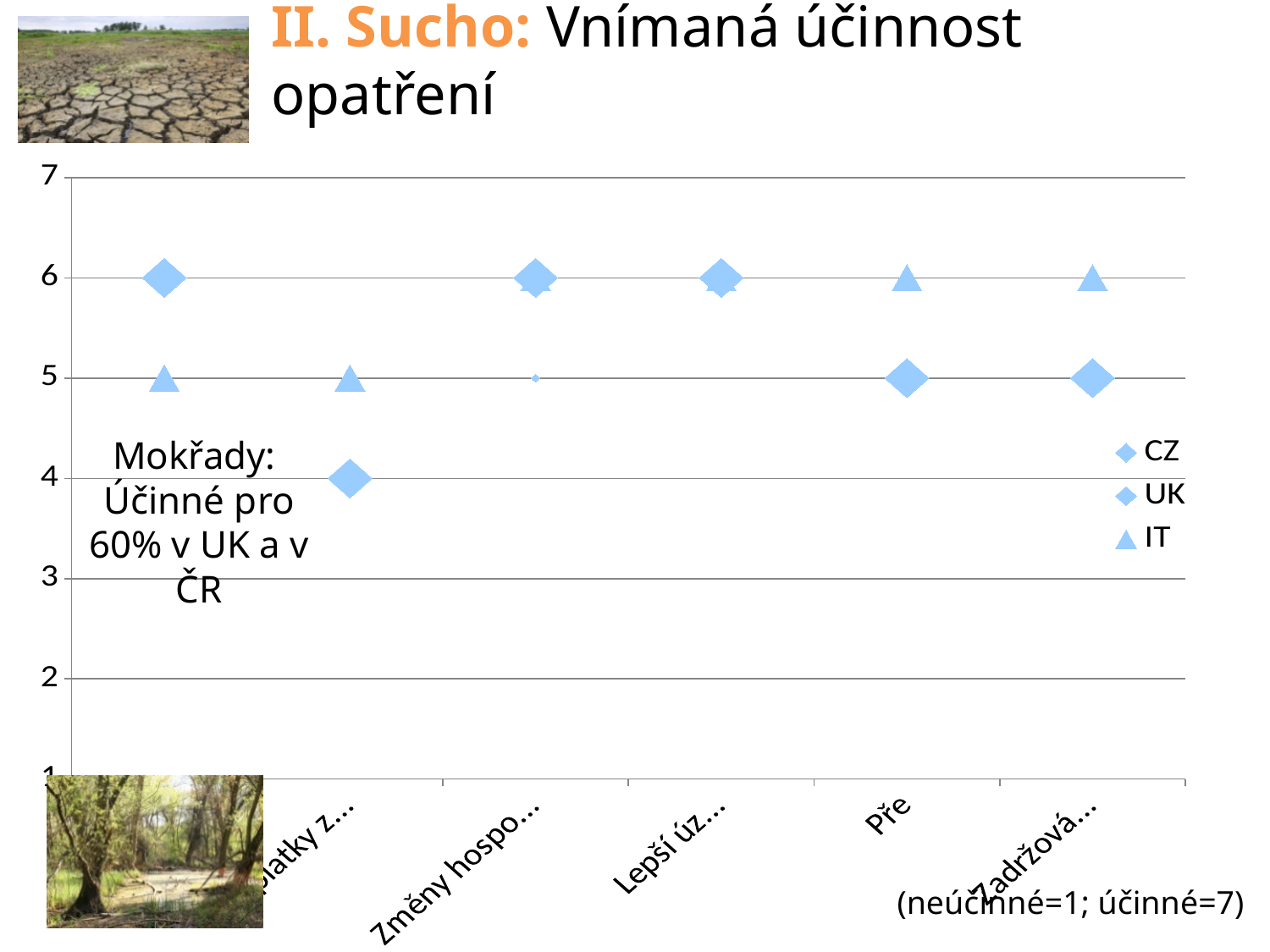
What is the highest value reached by any marker on the chart? 6 What is the highest value shown on the chart's vertical axis? 7 Which series is plotted with triangle markers? IT What kind of chart is shown on the slide? scatter chart What is the lowest value reached by any marker on the chart? 4 How many series does the chart legend list? 3 What are the series names shown in the chart legend? CZ, UK, IT